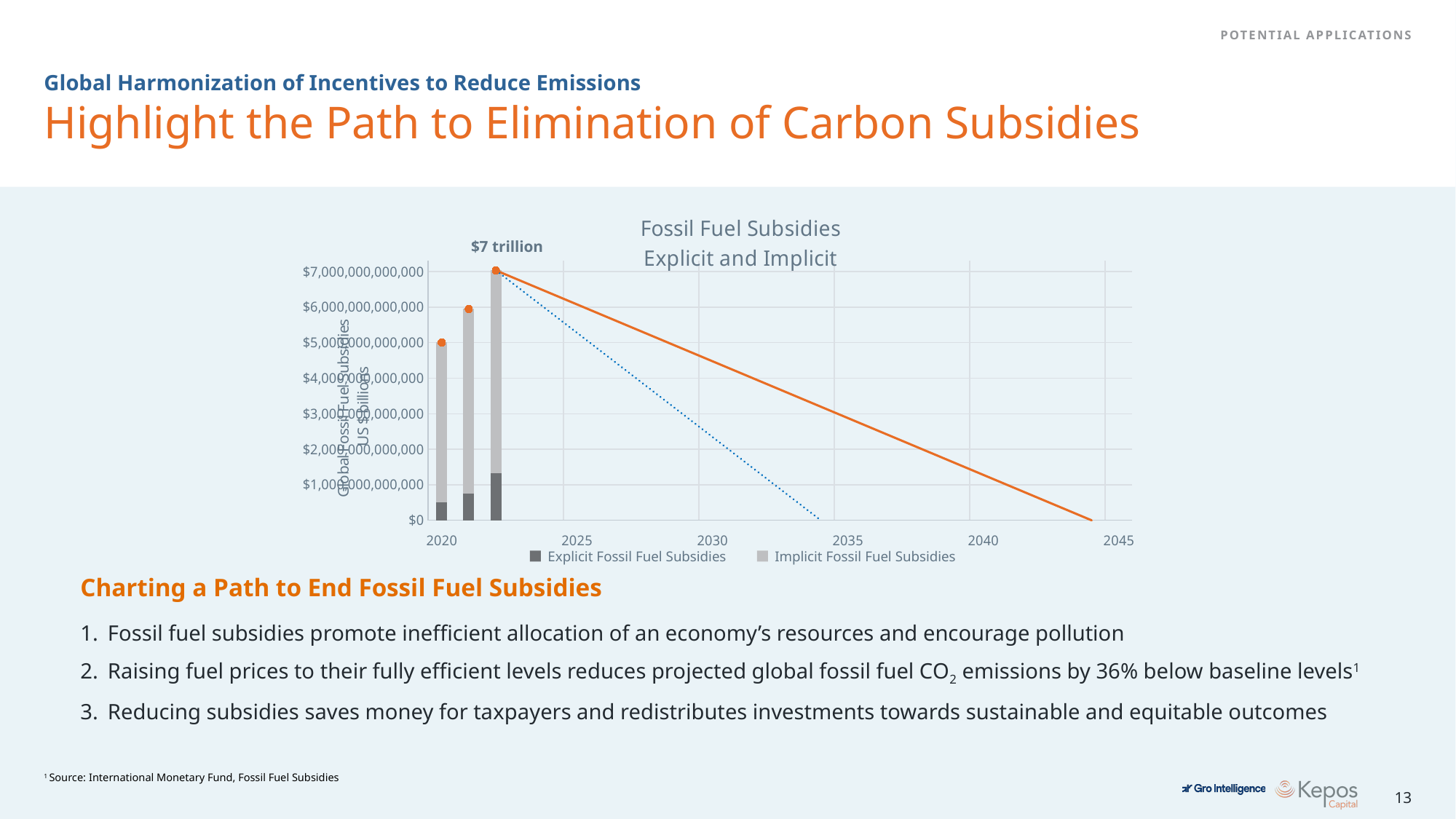
Is the total value for 2020 greater or less than $6,000,000,000,000? less How many bars are plotted in the chart? 3 What kind of chart is shown on the slide? combination bar and line chart What total value is annotated above the 2022 bar? $7 trillion Do the total subsidy bars rise or fall from 2020 to 2022? rise How many series does the legend list? 2 Which year has the lowest total fossil fuel subsidies bar? 2020 Is the Explicit Fossil Fuel Subsidies value for 2022 greater or less than $2,000,000,000,000? less Is the total value for 2021 greater or less than $5,000,000,000,000? greater What is the title of the chart? Fossil Fuel Subsidies Explicit and Implicit Which year has the highest total fossil fuel subsidies bar? 2022 In 2022, which is larger: Explicit Fossil Fuel Subsidies or Implicit Fossil Fuel Subsidies? Implicit Fossil Fuel Subsidies